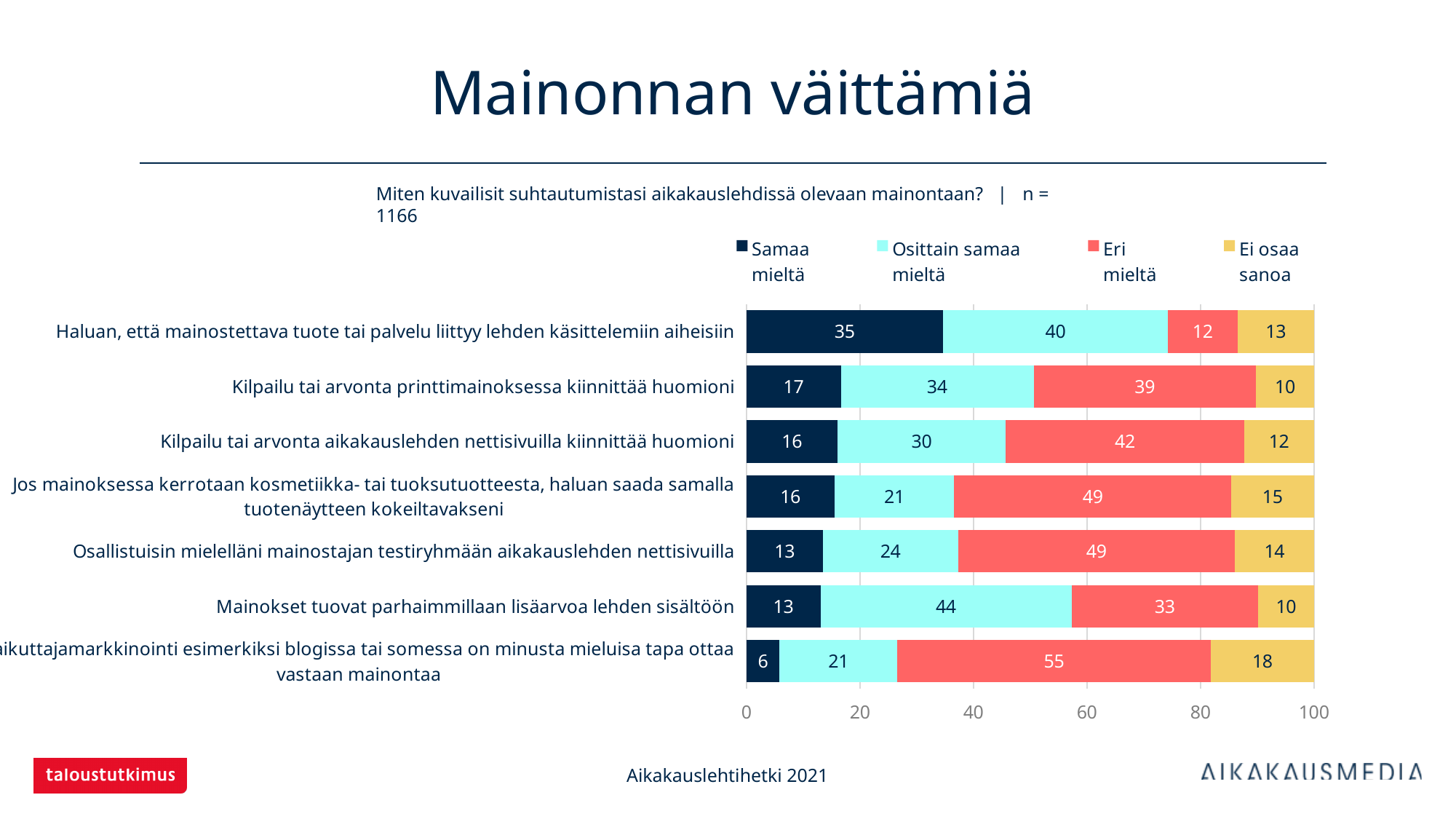
For 'Kilpailu tai arvonta printtimainoksessa kiinnittää huomioni', how much larger is the 'Eri mieltä' value than the 'Samaa mieltä' value? 22 What kind of chart is shown on the slide? Stacked bar chart Which statement has the highest 'Samaa mieltä' value? Haluan, että mainostettava tuote tai palvelu liittyy lehden käsittelemiin aiheisiin Which has the larger 'Osittain samaa mieltä' value: 'Kilpailu tai arvonta printtimainoksessa kiinnittää huomioni' or 'Kilpailu tai arvonta aikakauslehden nettisivuilla kiinnittää huomioni'? Kilpailu tai arvonta printtimainoksessa kiinnittää huomioni What is the 'Samaa mieltä' value for 'Mainokset tuovat parhaimmillaan lisäarvoa lehden sisältöön'? 13 How many series does the legend list? 4 How many statements (bars) are plotted in the chart? 7 What colour represents 'Eri mieltä' in the chart? Red Which statement has the highest 'Osittain samaa mieltä' value? Mainokset tuovat parhaimmillaan lisäarvoa lehden sisältöön What is the 'Eri mieltä' value for 'Kilpailu tai arvonta aikakauslehden nettisivuilla kiinnittää huomioni'? 42 What is the 'Eri mieltä' value for the bottom bar of the chart? 55 What is the 'Ei osaa sanoa' value for 'Jos mainoksessa kerrotaan kosmetiikka- tai tuoksutuotteesta, haluan saada samalla tuotenäytteen kokeiltavakseni'? 15